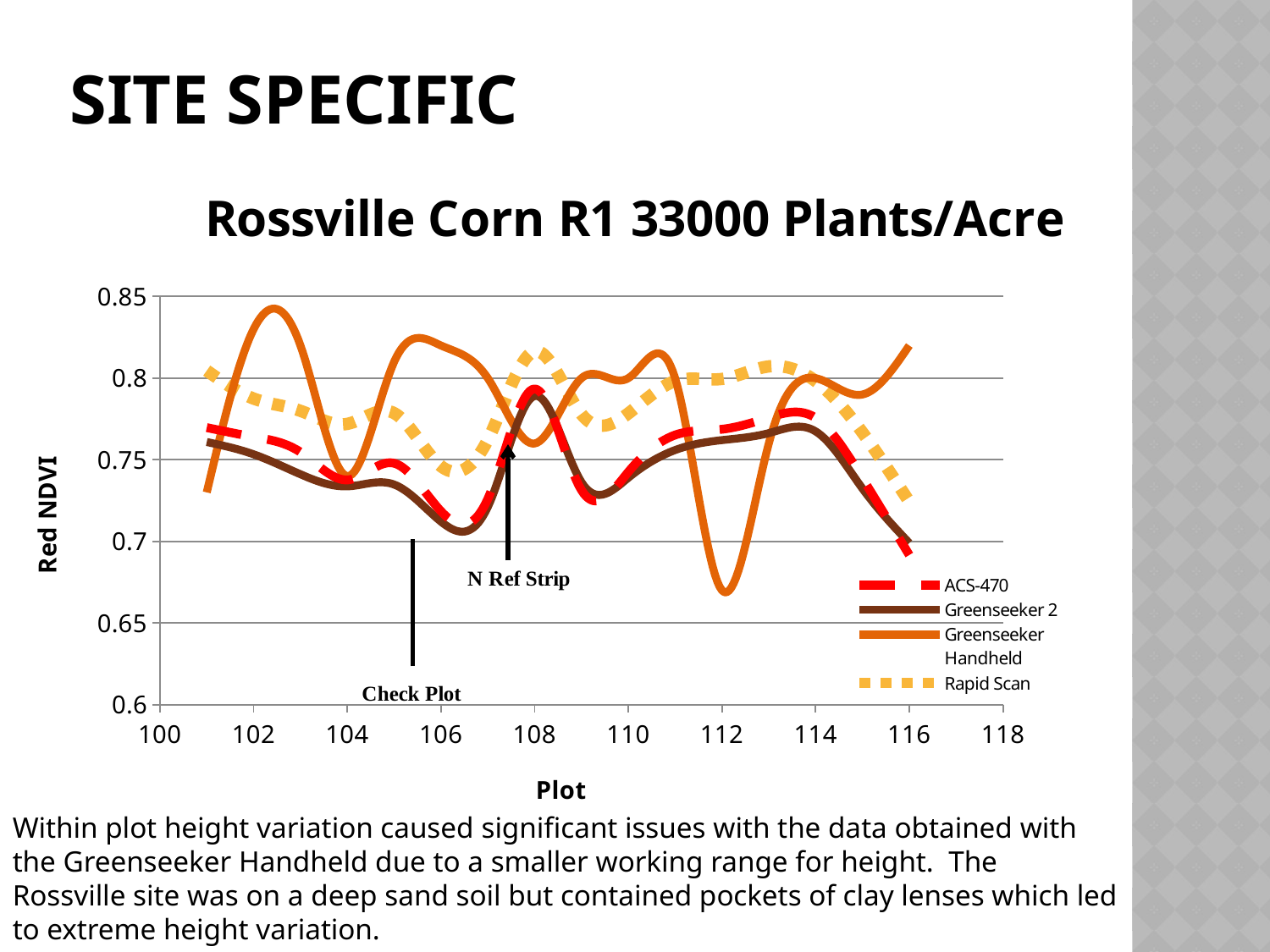
At plot 112, which is larger: Rapid Scan or Greenseeker Handheld? Rapid Scan Which series reaches the highest Red NDVI value on the chart? Greenseeker Handheld How many series does the legend list? 4 At plot 104, which is larger: Rapid Scan or Greenseeker 2? Rapid Scan Which series reaches the lowest Red NDVI value on the chart? Greenseeker Handheld What kind of chart is shown on the slide? line chart Is the value for Greenseeker 2 at plot 101 greater or less than 0.75? greater What is the title of the chart? Rossville Corn R1 33000 Plants/Acre Is the value for Rapid Scan at plot 108 greater or less than 0.8? greater What two annotations are marked with arrows on the chart? Check Plot and N Ref Strip Is the value for Greenseeker Handheld at plot 101 greater or less than 0.75? less